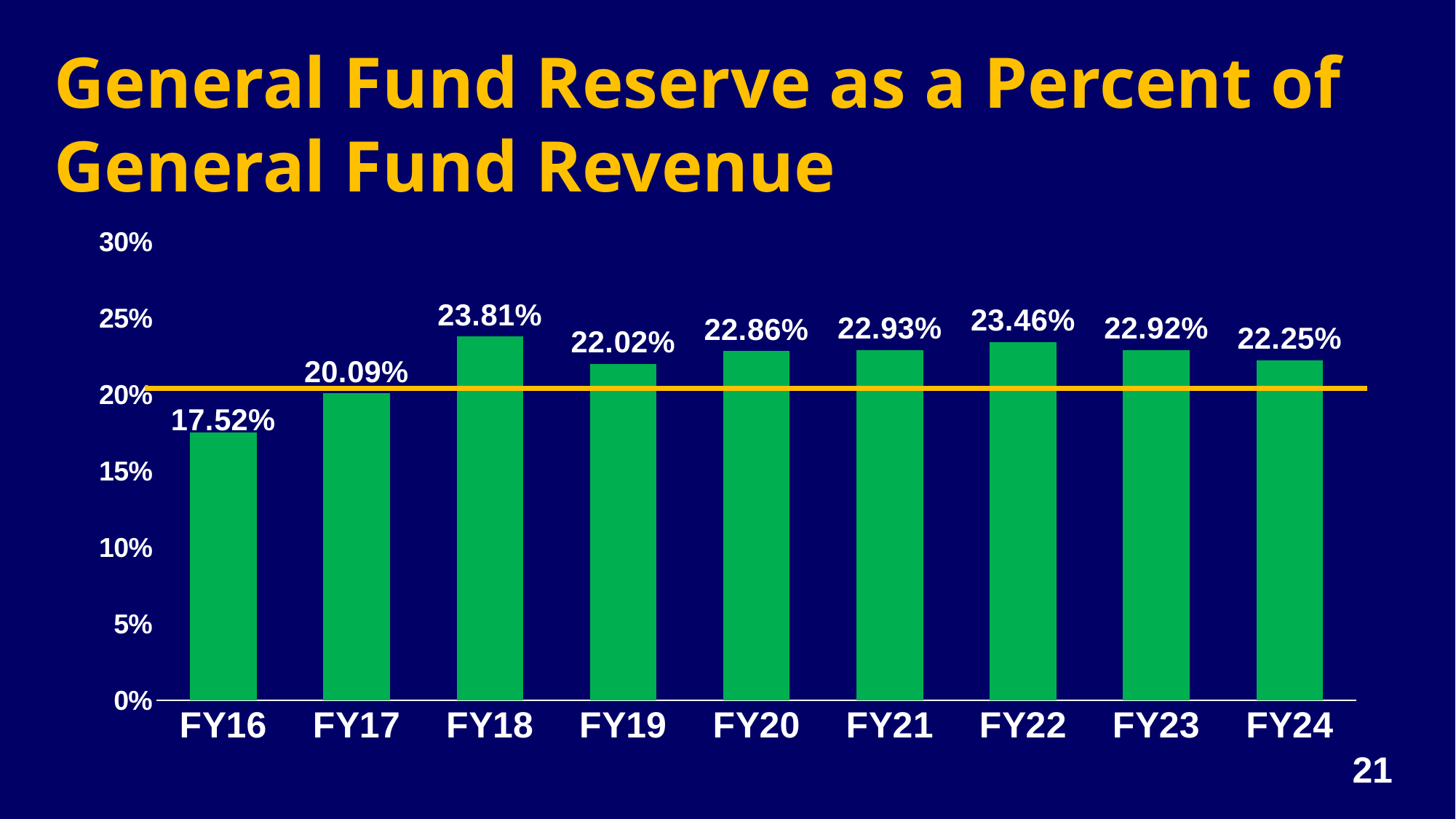
What value is shown for FY22? 23.46% How many fiscal years are shown on the x axis? 9 What is the difference in percentage points between FY17 and FY16? 2.57 percentage points What is the value for FY24? 22.25% What kind of chart is shown on the slide? Bar chart At what percentage level is the horizontal yellow line drawn across the chart? 20% Which fiscal year has the lowest General Fund Reserve percentage? FY16 Which is larger, the value for FY18 or the value for FY19? FY18 Is the value for FY16 greater or less than 20%? less What is the General Fund Reserve as a percent of General Fund Revenue for FY16? 17.52% Which fiscal year has the highest General Fund Reserve percentage? FY18 What is the difference in percentage points between FY18 and FY16? 6.29 percentage points